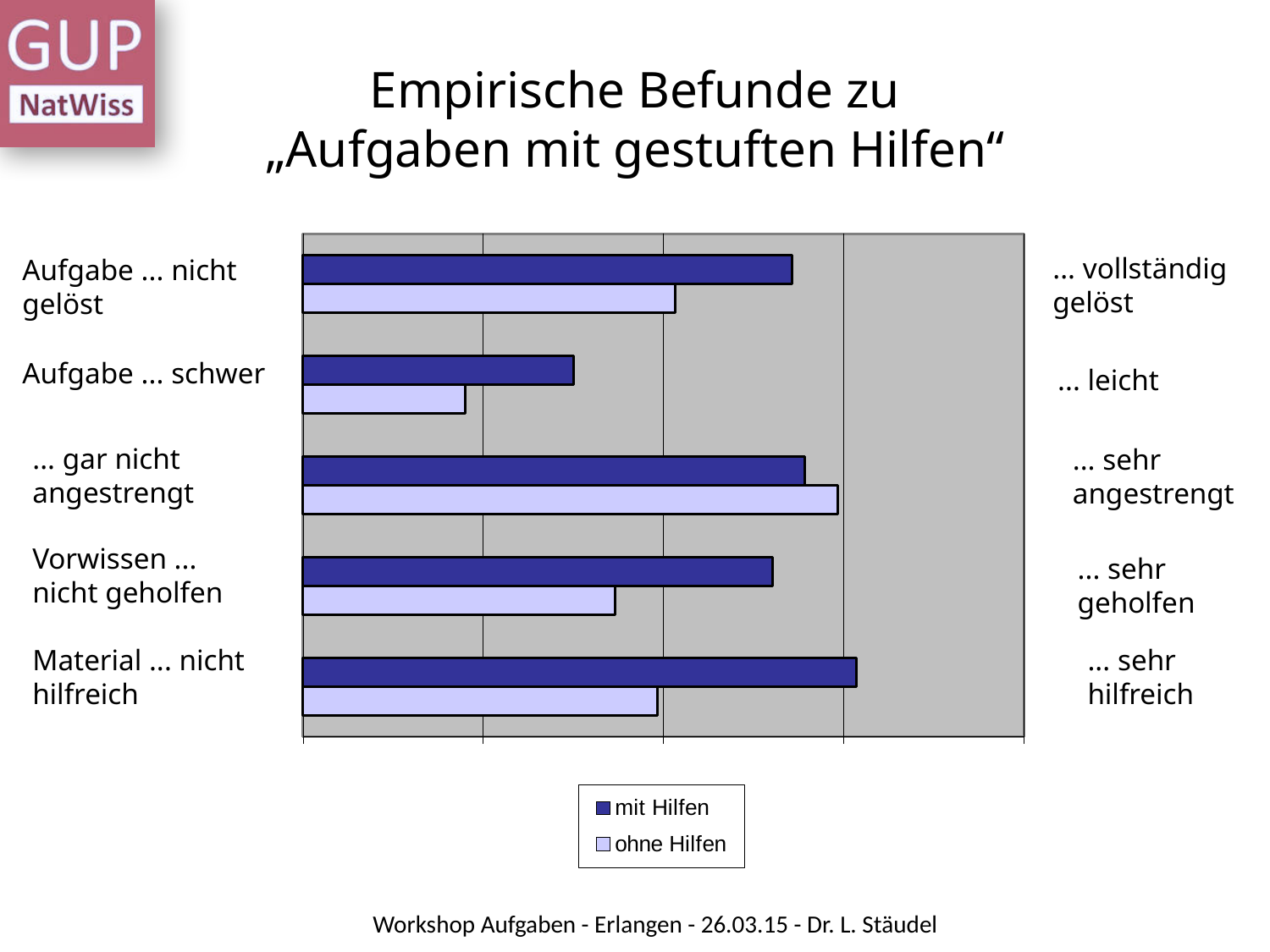
Which row has the shortest bar for the series 'mit Hilfen'? Aufgabe ... schwer / ... leicht Which row has the longest bar for the series 'mit Hilfen'? Material ... nicht hilfreich / ... sehr hilfreich What kind of chart is shown on the slide? bar chart For the row 'Material ... nicht hilfreich / ... sehr hilfreich', which series has the longer bar, mit Hilfen or ohne Hilfen? mit Hilfen What are the two series named in the legend? mit Hilfen, ohne Hilfen For the row 'Aufgabe ... nicht gelöst / ... vollständig gelöst', which series has the longer bar, mit Hilfen or ohne Hilfen? mit Hilfen Which row has the shortest bar for the series 'ohne Hilfen'? Aufgabe ... schwer / ... leicht For the row 'Vorwissen ... nicht geholfen / ... sehr geholfen', which series has the longer bar, mit Hilfen or ohne Hilfen? mit Hilfen How many category pairs (rows of bars) are plotted in the chart? 5 How many series does the legend list? 2 Which row has the longest bar for the series 'ohne Hilfen'? ... gar nicht angestrengt / ... sehr angestrengt